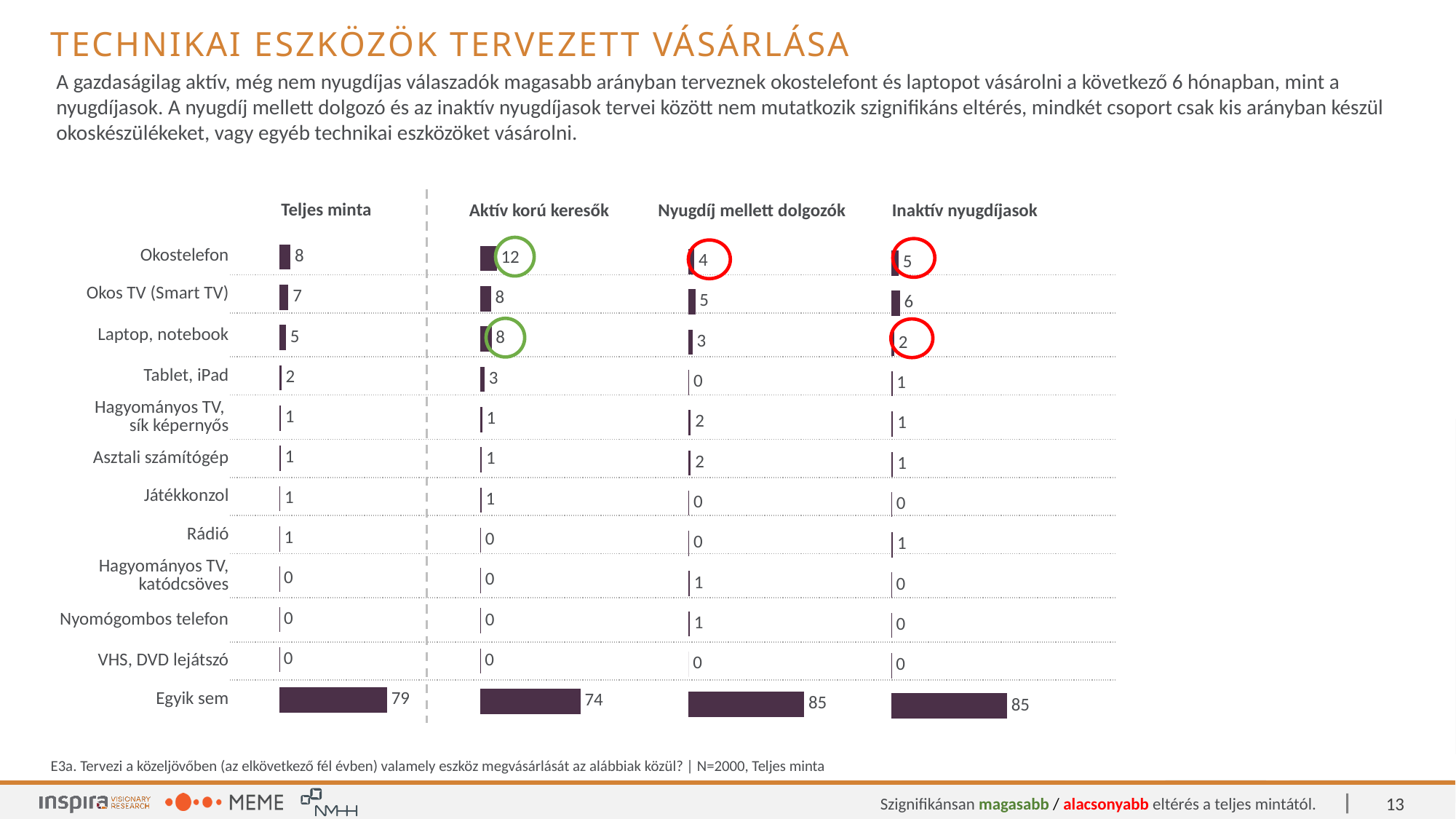
How many categories are listed in the "Teljes minta" chart? 12 In the "Teljes minta" chart, what is the value for Okostelefon? 8 What type of chart is used for the "Inaktív nyugdíjasok" data? Bar chart In the "Aktív korú keresők" chart, which category has the highest value? Egyik sem How many group charts are shown to the right of the dashed line? 3 Which is larger: the Egyik sem value in the "Teljes minta" chart or in the "Aktív korú keresők" chart? Teljes minta In the "Teljes minta" chart, which category has the highest value apart from Egyik sem? Okostelefon What is the difference between the Egyik sem values in the "Inaktív nyugdíjasok" chart and the "Teljes minta" chart? 6 In the "Inaktív nyugdíjasok" chart, what is the value for Okos TV (Smart TV)? 6 What is the difference between the Okostelefon values in the "Aktív korú keresők" chart and the "Nyugdíj mellett dolgozók" chart? 8 In the "Nyugdíj mellett dolgozók" chart, what is the value for Egyik sem? 85 In the "Aktív korú keresők" chart, what is the value for Laptop, notebook? 8